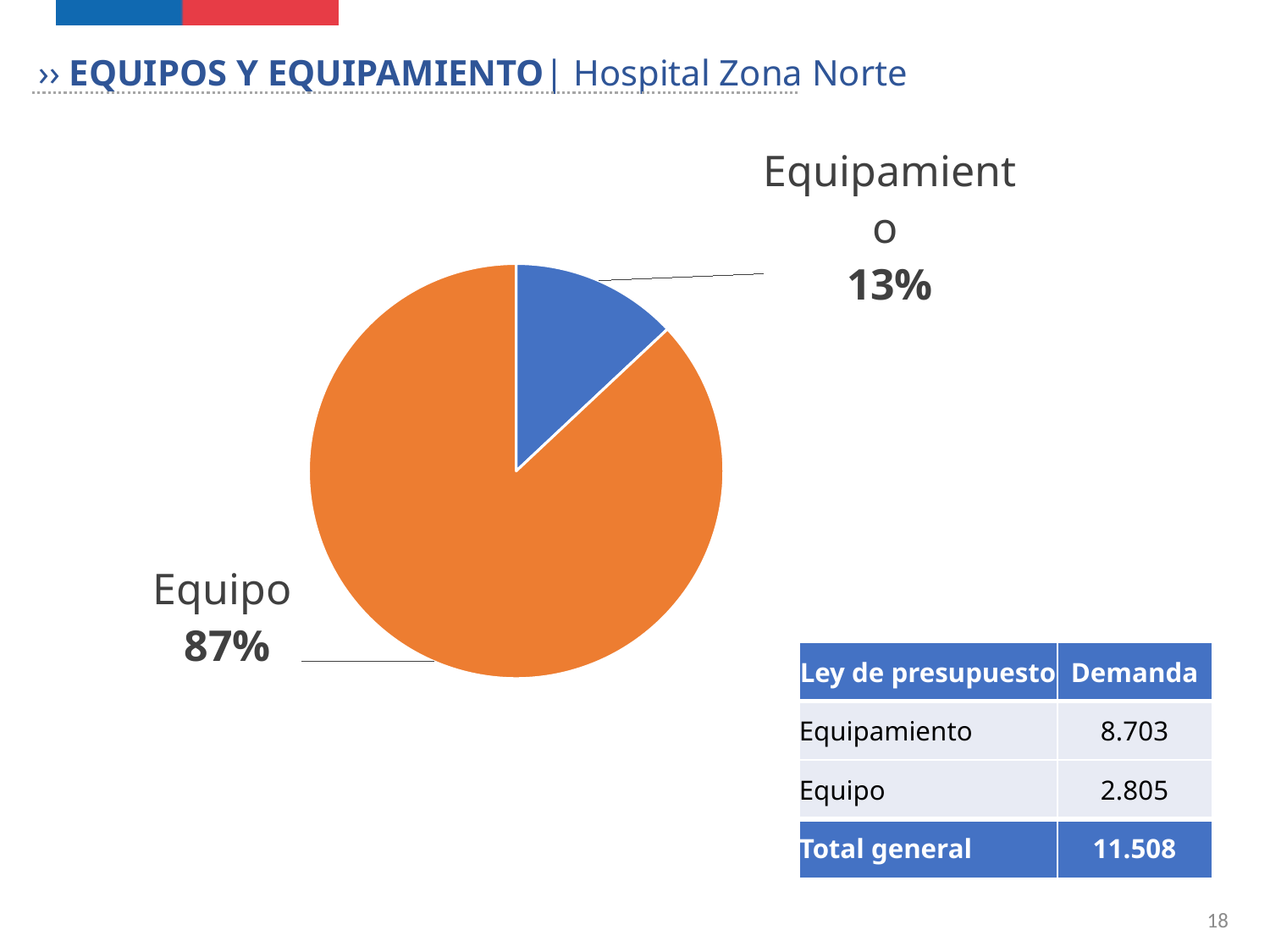
What is the difference in percentage points between the Equipo and Equipamiento slices? 74 Which slice of the pie chart is the largest? Equipo What kind of chart is shown on the slide? pie chart What percentage does the pie chart show for Equipamiento? 13% What share of the pie does the Equipamiento slice represent? 13% Which slice of the pie chart is the smallest? Equipamiento What colour is the Equipo slice in the pie chart? orange What percentage does the pie chart show for Equipo? 87% Which is larger in the pie chart, Equipo or Equipamiento? Equipo What colour is the Equipamiento slice in the pie chart? blue How many slices does the pie chart have? 2